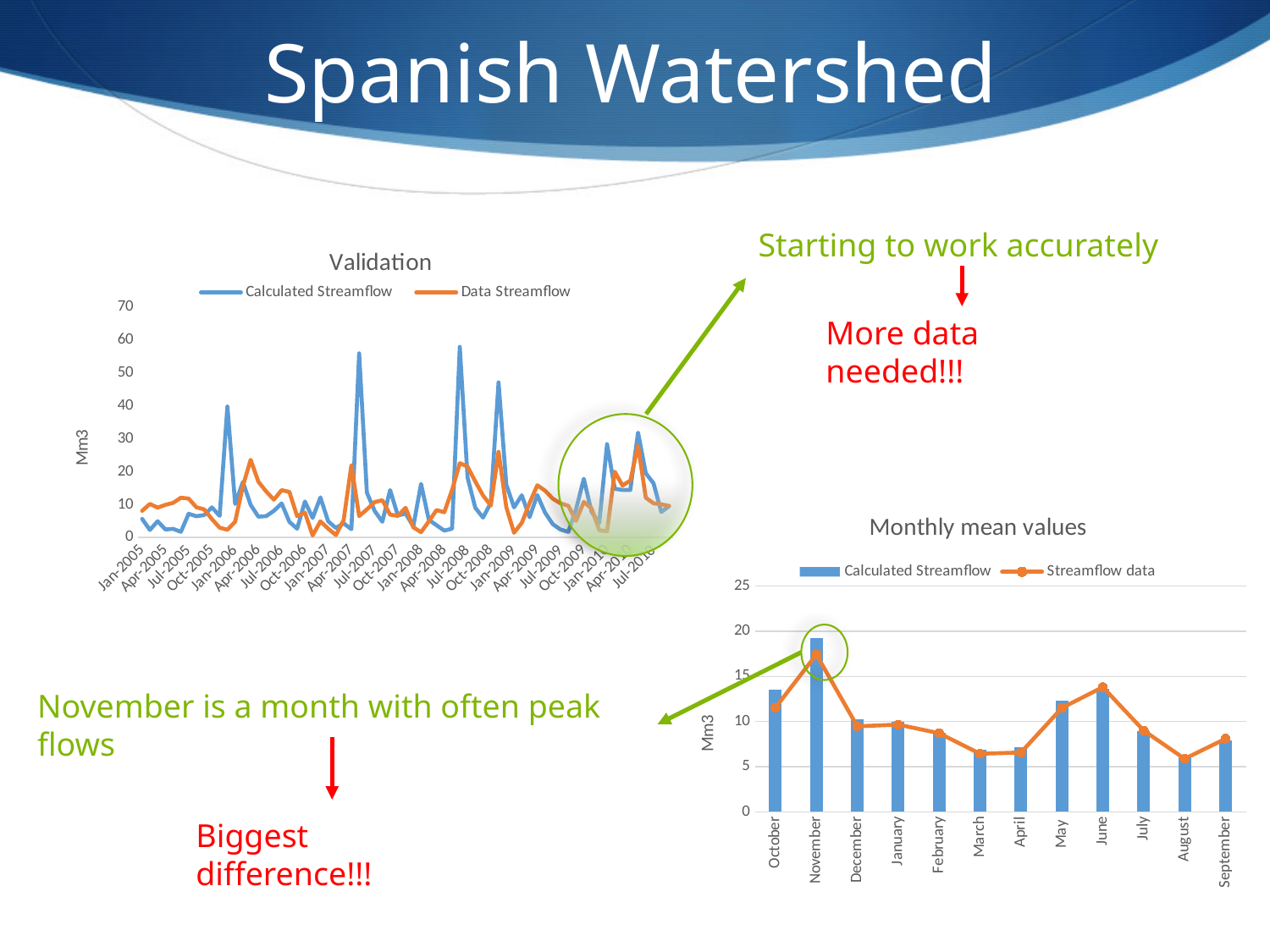
In the Monthly mean values chart, is the Calculated Streamflow value for March greater or less than 10? less In the Monthly mean values chart, how many series does the legend list? 2 In the Monthly mean values chart, is the Calculated Streamflow value for November greater or less than 15? greater What unit is shown on the y axis of the Validation chart? Mm3 In the Validation chart, is the highest value of Data Streamflow greater or less than 30? less In the Validation chart, how many series does the legend list? 2 In the Monthly mean values chart, which month has the highest Calculated Streamflow bar? November What kind of chart is the Validation chart? line chart In the Monthly mean values chart, how many months are shown on the x axis? 12